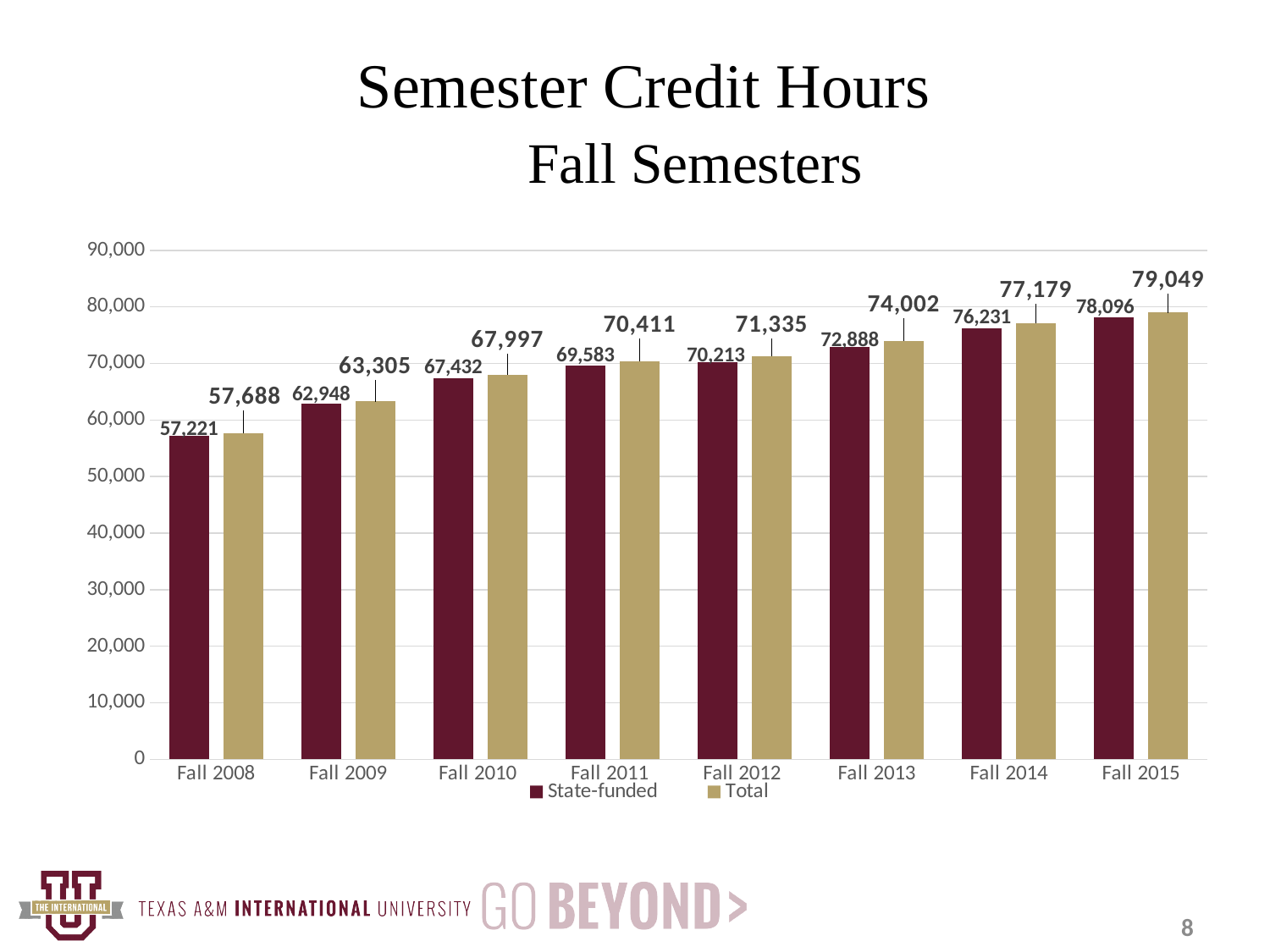
What is the Total value for Fall 2011? 70,411 Which fall semester has the highest Total value? Fall 2015 What is the difference between the Total and State-funded values for Fall 2013? 1,114 Do the Total values rise or fall from Fall 2008 to Fall 2015? Rise Which is larger, the State-funded value for Fall 2012 or the Total value for Fall 2010? State-funded for Fall 2012 How many series does the legend list? 2 What is the Total value for Fall 2015? 79,049 How many fall semesters are shown on the x axis? 8 Which fall semester has the lowest State-funded value? Fall 2008 What kind of chart is shown on the slide? Bar chart What is the State-funded value for Fall 2008? 57,221 Is the Total value for Fall 2009 greater or less than 60,000? greater